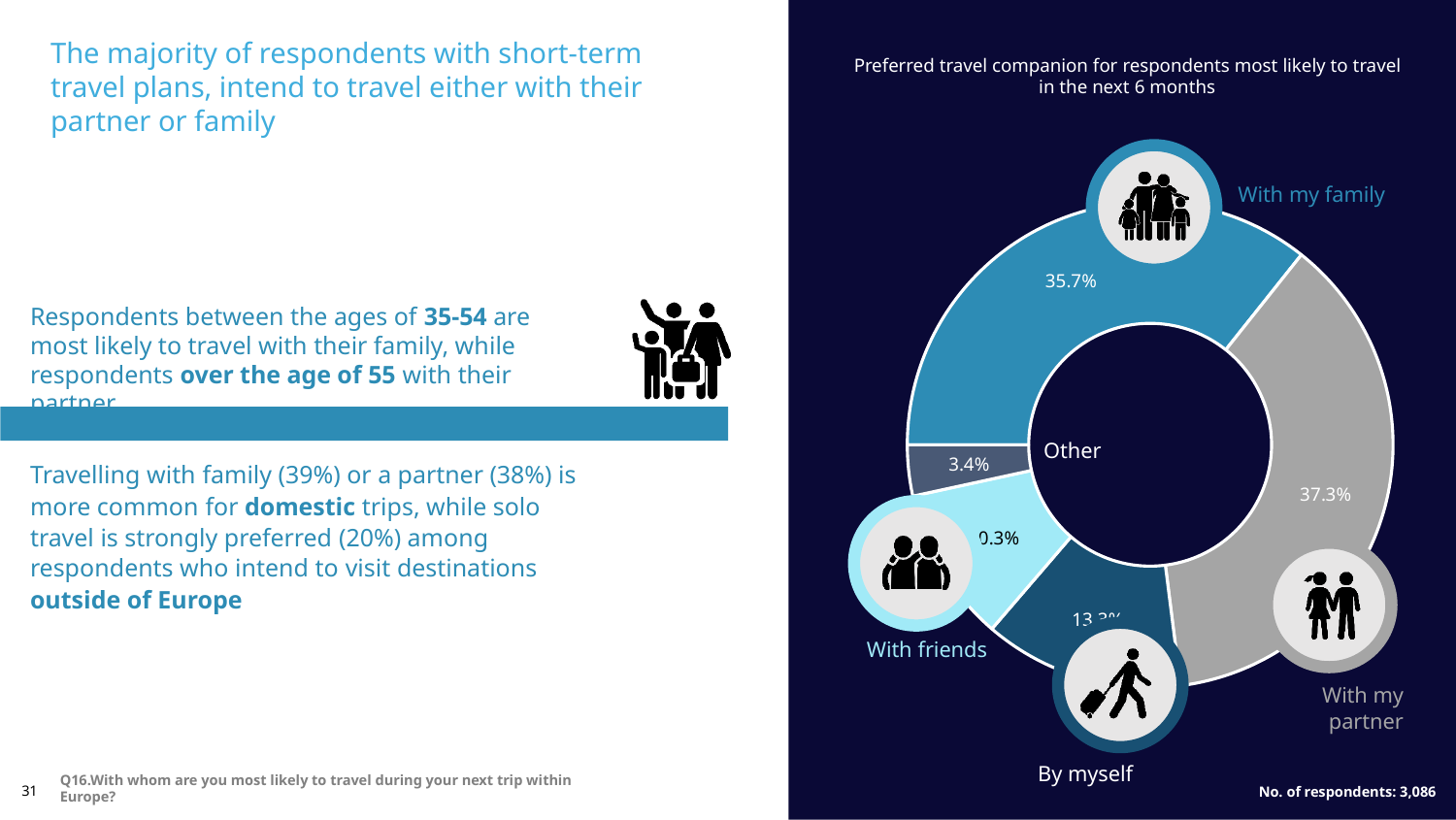
What share of respondents prefer to travel with their family? 35.7% What type of chart is used to show the preferred travel companion? Pie (donut) chart What share of respondents prefer to travel with their partner? 37.3% What is the difference in percentage points between 'With my partner' and 'With my family'? 1.6 percentage points Which is larger: the share for 'Other' or 'With my family'? With my family Which travel companion category has the smallest share? Other What is the title of the chart? Preferred travel companion for respondents most likely to travel in the next 6 months How many respondents does the chart note as its base? 3,086 Which is larger: the share for 'With my family' or 'With my partner'? With my partner Which travel companion category has the largest share? With my partner What share of respondents fall into the 'Other' category? 3.4% How many travel companion categories are shown in the chart? 5